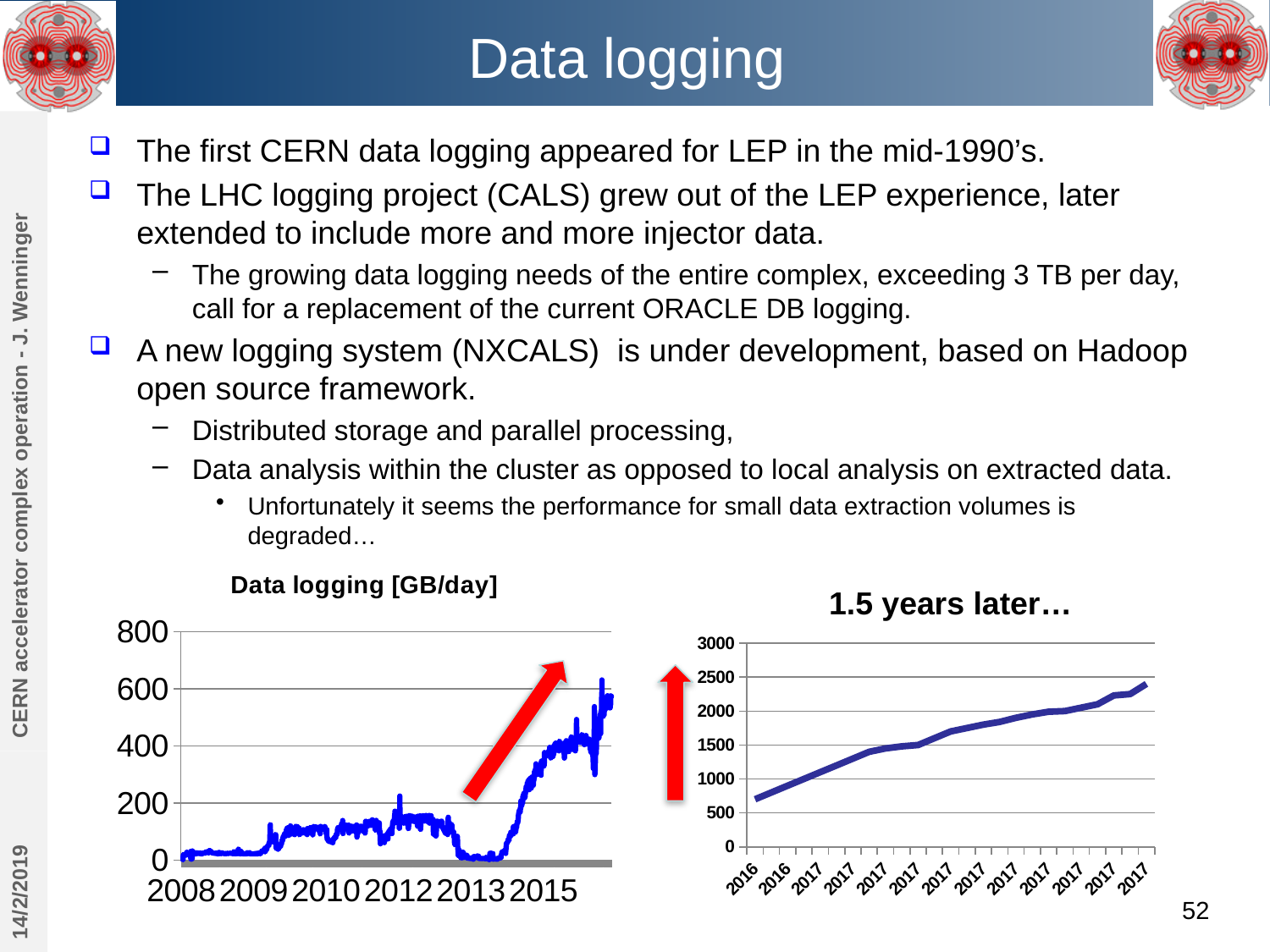
In the right chart "1.5 years later…", do the values rise or fall along the x axis from 2016 to 2017? rise In the left chart "Data logging [GB/day]", does the data logging rate overall rise or fall from 2008 to 2015? rise In the right chart "1.5 years later…", is the last plotted value in 2017 greater or less than 2000? greater In the right chart "1.5 years later…", which is larger: the first value in 2016 or the last value in 2017? the last value in 2017 What kind of chart is the right chart titled "1.5 years later…"? line chart How many year labels are shown on the x axis of the left chart "Data logging [GB/day]"? 6 In the left chart "Data logging [GB/day]", which is larger: the value in 2010 or the value in 2015? 2015 In the left chart "Data logging [GB/day]", is the highest value reached in 2015 greater or less than 400? greater What is the title of the left chart on the slide? Data logging [GB/day] What kind of chart is the left chart titled "Data logging [GB/day]"? line chart In the right chart "1.5 years later…", is the first plotted value in 2016 greater or less than 1000? less